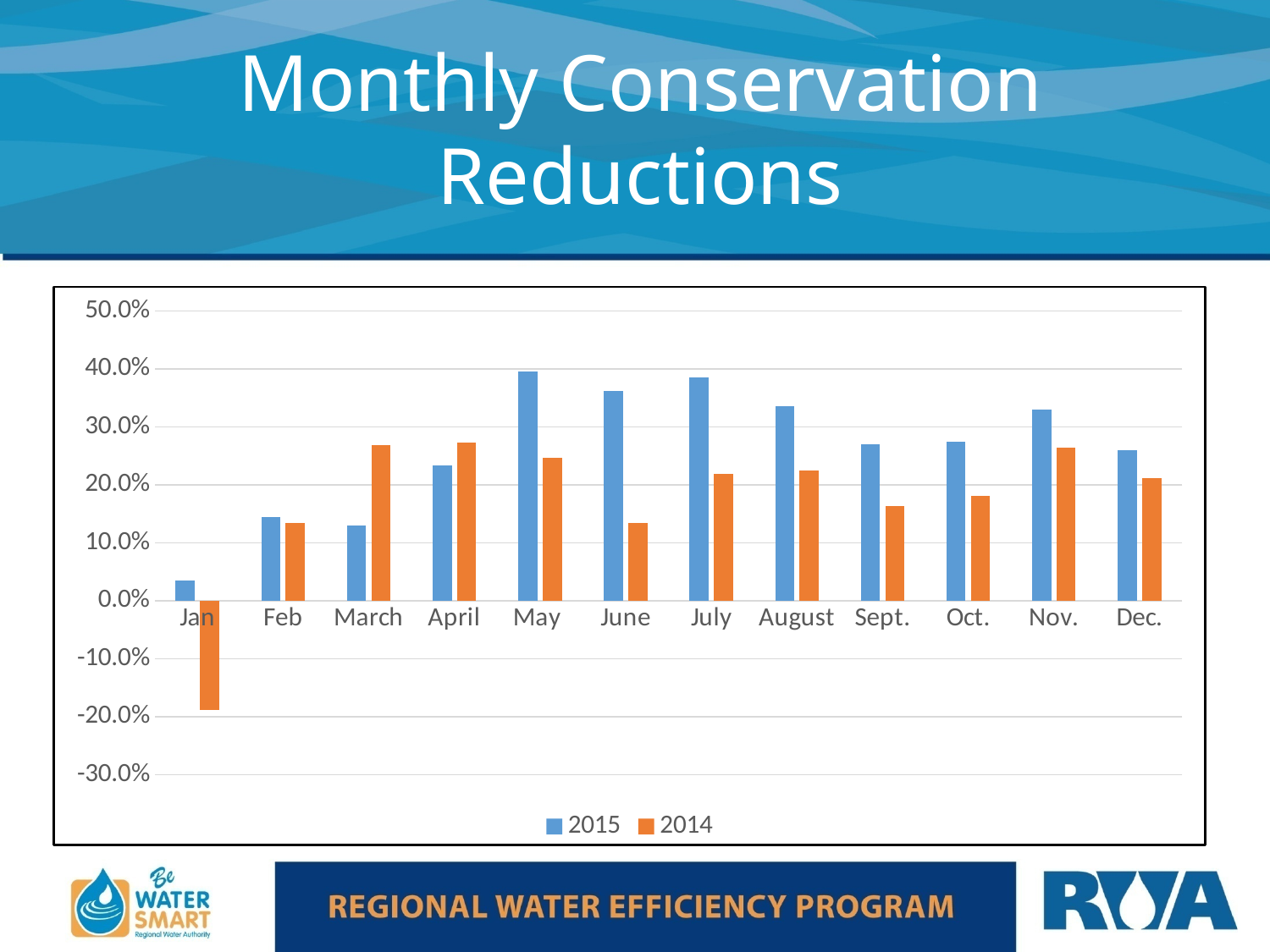
Is the 2015 value for Jan greater or less than 10.0%? less Which colour represents the 2014 series in the chart? orange How many series does the chart's legend list? 2 What kind of chart is shown on the slide? bar chart Is the 2014 value for Jan greater or less than -10.0%? less Which month has the lowest value for the 2015 series? Jan Which month has the lowest value for the 2014 series? Jan Is the 2015 value for May greater or less than 30.0%? greater For June, which series has the larger value, 2015 or 2014? 2015 For March, which series has the larger value, 2015 or 2014? 2014 How many months are shown on the x axis of the chart? 12